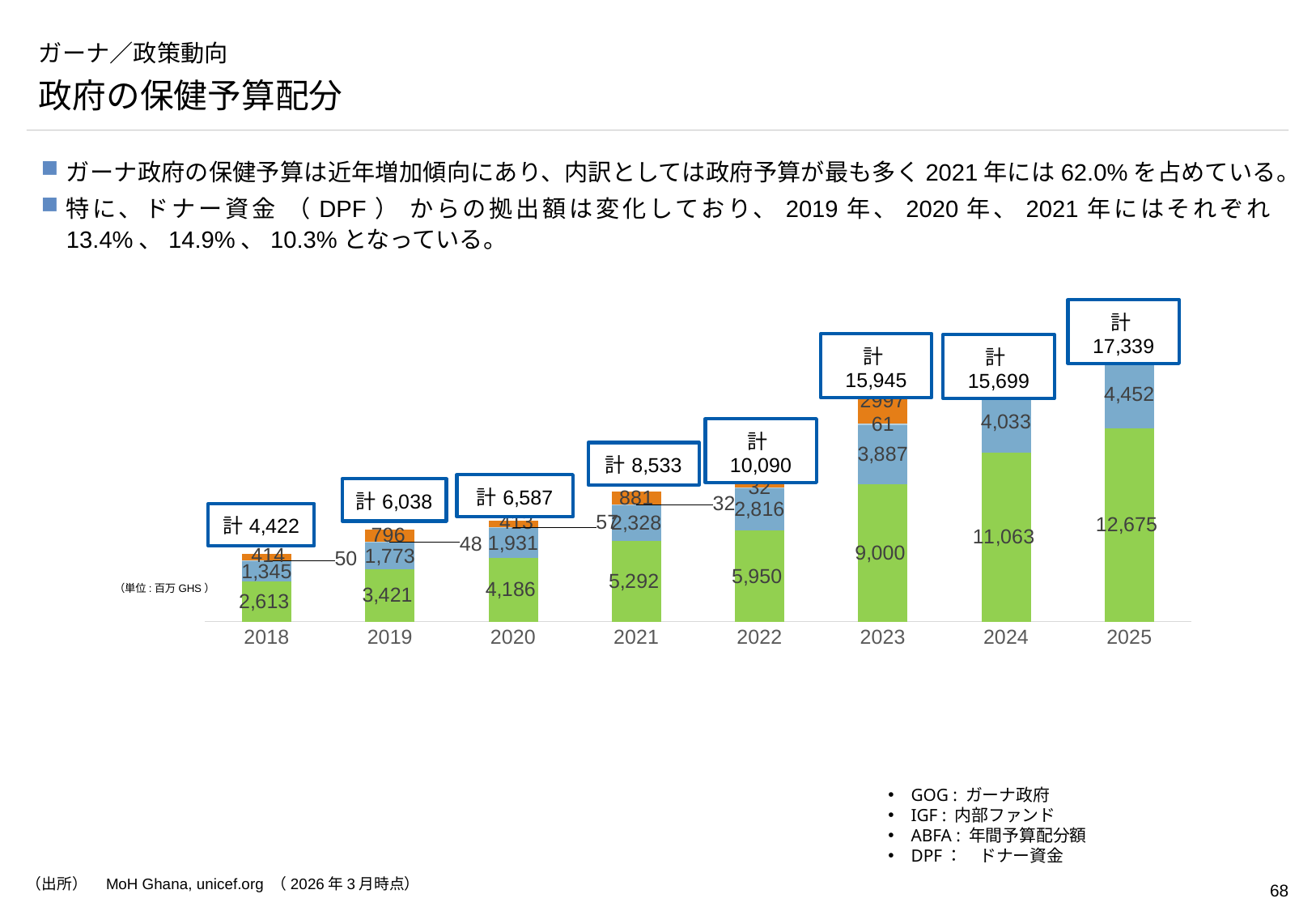
Which year has the highest total (計)? 2025 Which total is larger, 2023 or 2024? 2023 What is the difference between the totals for 2025 and 2024? 1,640 What is the value of the blue (middle) segment for 2024? 4,033 What is the value of the green (bottom) segment for 2025? 12,675 What is the value of the green (bottom) segment for 2023? 9,000 What is the total (計) for 2018? 4,422 What kind of chart is shown on the slide? Stacked bar chart What unit is stated for the chart values? 百万 GHS Which year has the lowest total (計)? 2018 What is the total (計) for 2025? 17,339 How many years are shown on the x axis of the chart? 8